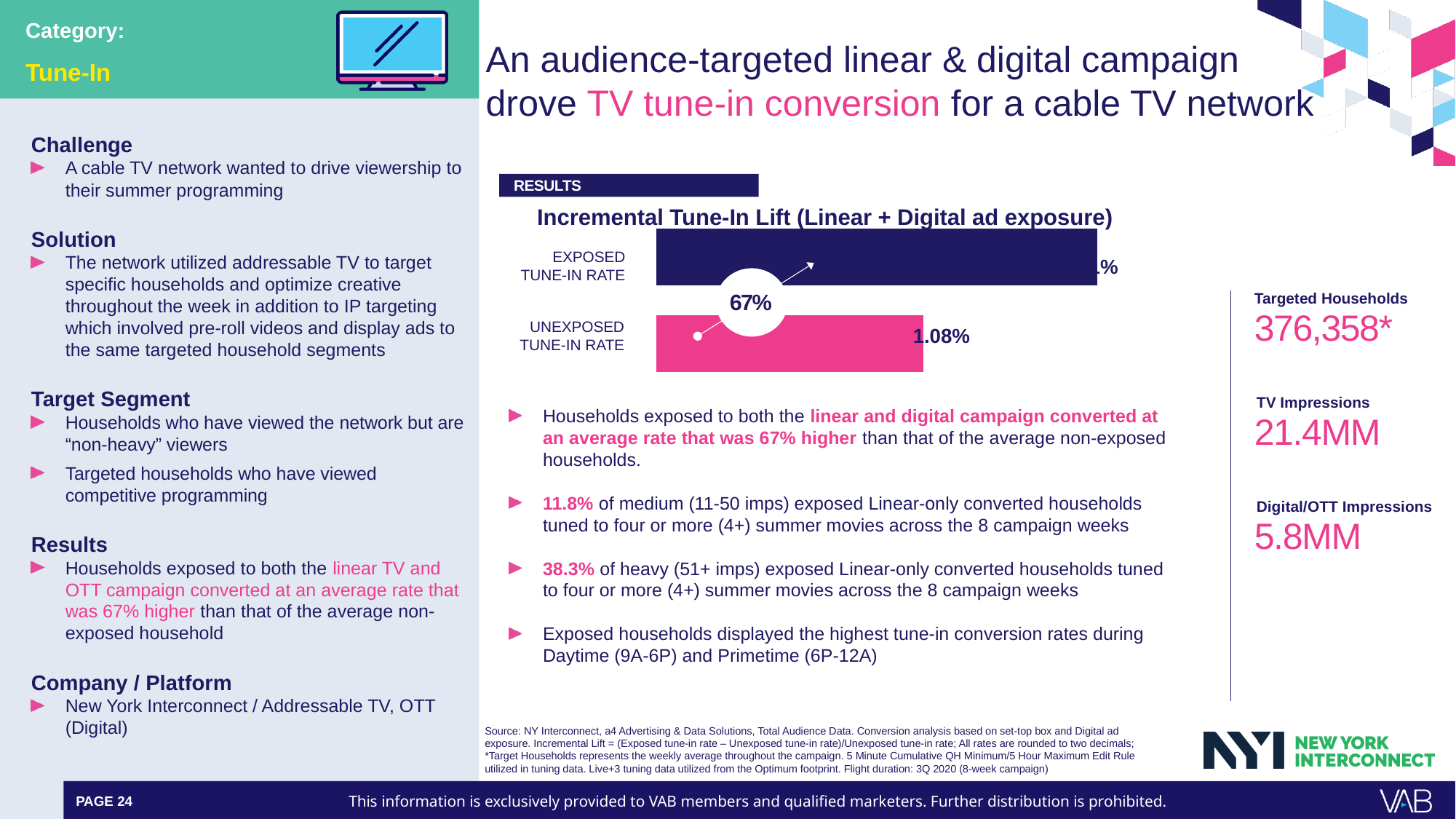
Is the exposed tune-in rate bar longer or shorter than the unexposed tune-in rate bar? Longer What is the title of the chart? Incremental Tune-In Lift (Linear + Digital ad exposure) What percentage lift is shown in the circle callout between the two bars? 67% Which category has the longer bar in the chart, exposed tune-in rate or unexposed tune-in rate? Exposed tune-in rate What is the unexposed tune-in rate shown in the chart? 1.08% What kind of chart is shown on the slide? Bar chart Which category has the shorter bar in the chart? Unexposed tune-in rate How many bars are plotted in the chart? 2